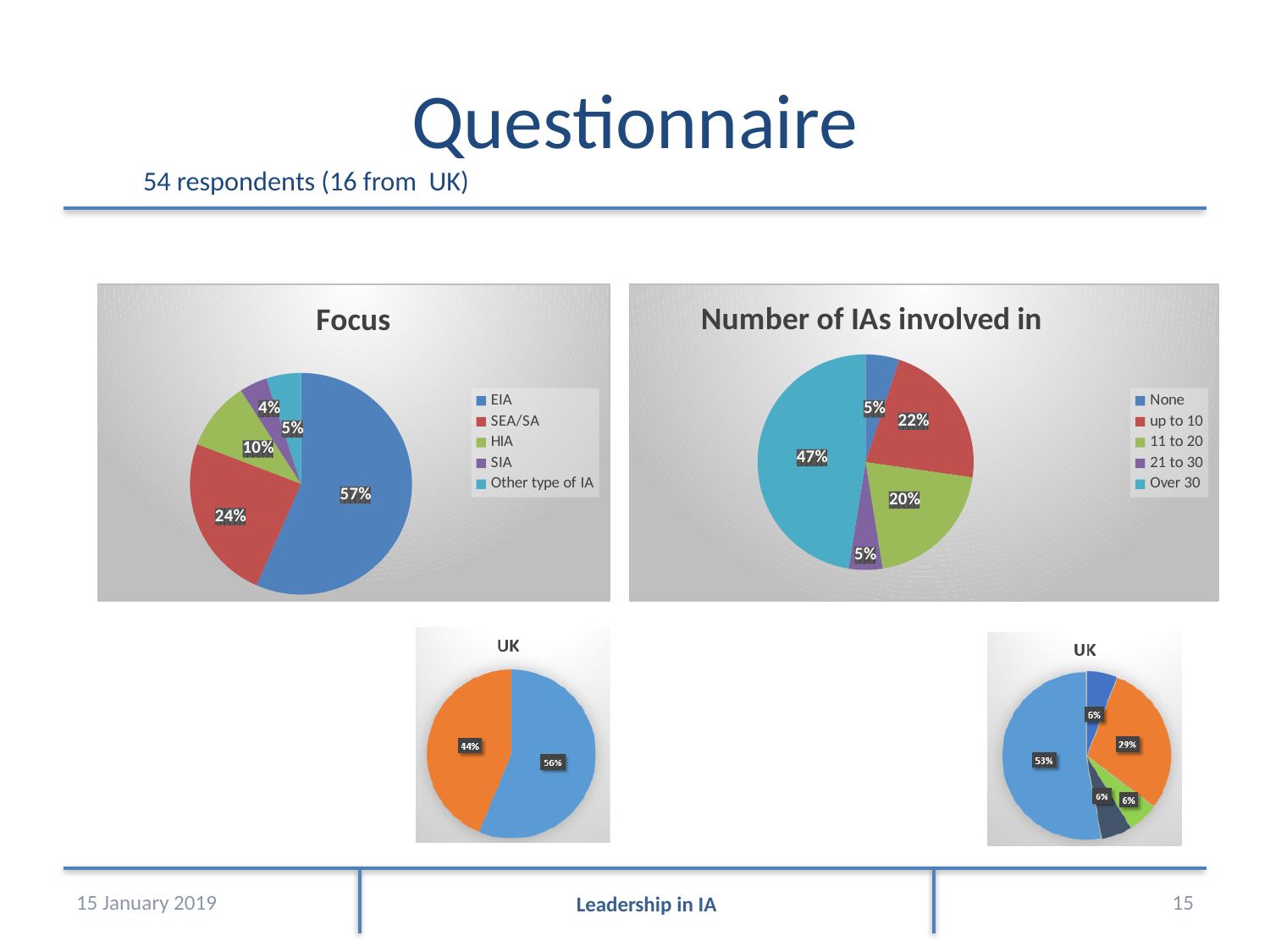
In the UK chart at the bottom right, what is the percentage of the largest slice? 53% In the UK chart at the bottom left, what is the percentage of the largest slice? 56% In the Number of IAs involved in chart, which category has the largest slice? Over 30 In the Focus chart, what share of respondents is shown for EIA? 57% How many categories does the legend of the Focus chart list? 5 In the Focus chart, what percentage is shown for SEA/SA? 24% In the Number of IAs involved in chart, what percentage is shown for 11 to 20? 20% In the Number of IAs involved in chart, which is larger: up to 10 or 11 to 20? up to 10 In the Number of IAs involved in chart, what percentage is shown for Over 30? 47% What type of chart is the Number of IAs involved in chart? Pie chart In the Focus chart, what is the difference between the EIA and SEA/SA percentages? 33% In the Focus chart, which category has the smallest slice? SIA